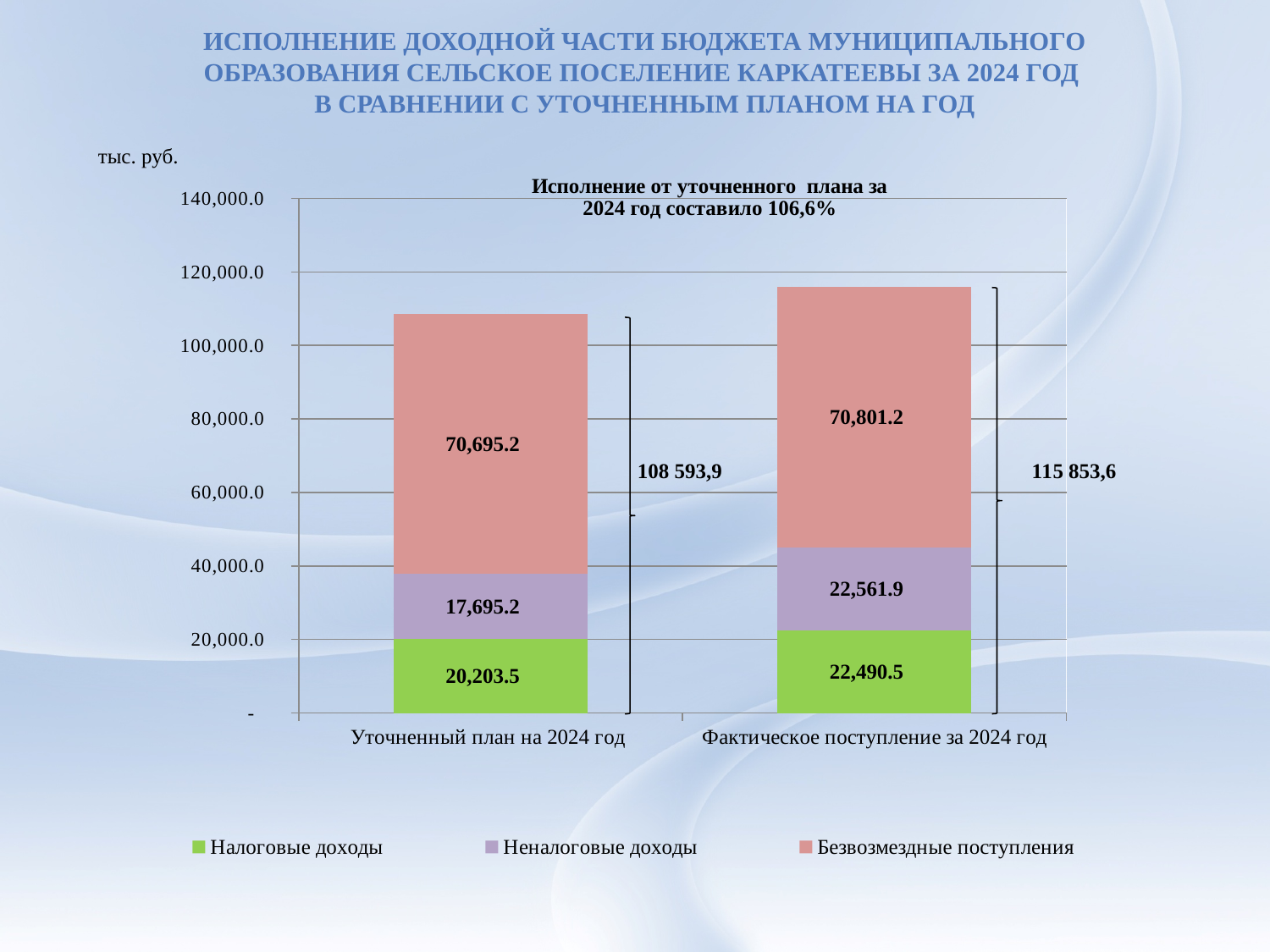
What is the value of Налоговые доходы for Уточненный план на 2024 год? 20,203.5 What is the difference between Неналоговые доходы for Фактическое поступление за 2024 год and for Уточненный план на 2024 год? 4,866.7 How many categories are shown on the x axis? 2 Which series has the highest value in the Фактическое поступление за 2024 год bar? Безвозмездные поступления How many series does the legend list? 3 What is the total of the stacked bar for Фактическое поступление за 2024 год? 115 853,6 What is the value of Безвозмездные поступления for Уточненный план на 2024 год? 70,695.2 What type of chart is shown on the slide? Stacked bar chart What is the total of the stacked bar for Уточненный план на 2024 год? 108 593,9 Which category has the larger value for Налоговые доходы: Уточненный план на 2024 год or Фактическое поступление за 2024 год? Фактическое поступление за 2024 год What is the value of Неналоговые доходы for Фактическое поступление за 2024 год? 22,561.9 According to the text inside the chart, what percentage of the adjusted plan was executed in 2024? 106,6%